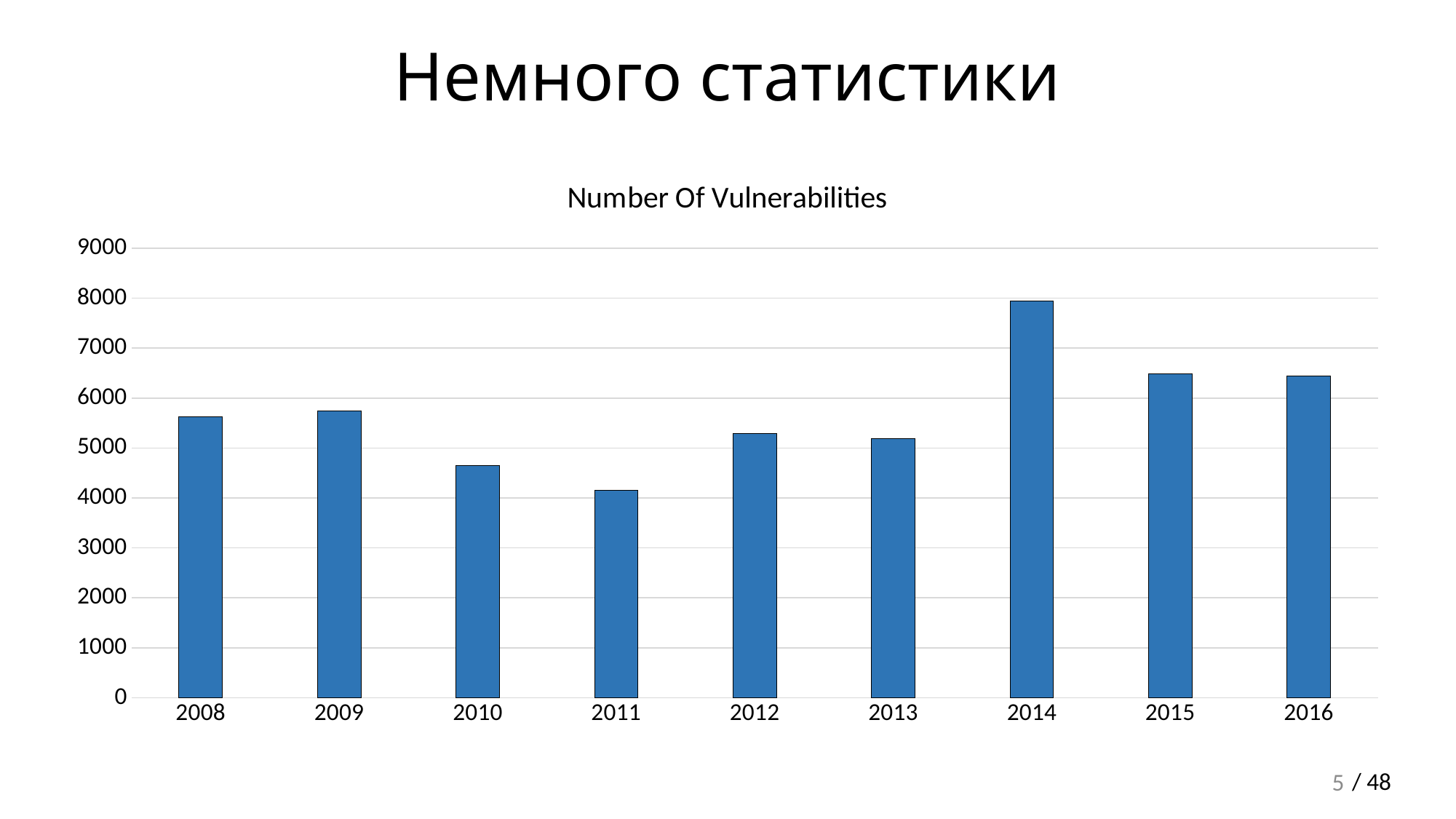
Do the values rise or fall from 2009 to 2011? fall What is the title of the chart? Number Of Vulnerabilities Is the value for 2011 greater or less than 5000? less How many years are shown on the x axis of the chart? 9 Which is larger, the value for 2014 or the value for 2015? 2014 Is the value for 2010 greater or less than 5000? less Which year has the lowest number of vulnerabilities? 2011 Is the value for 2008 greater or less than 6000? less What kind of chart is shown on the slide? bar chart Which year has the highest number of vulnerabilities? 2014